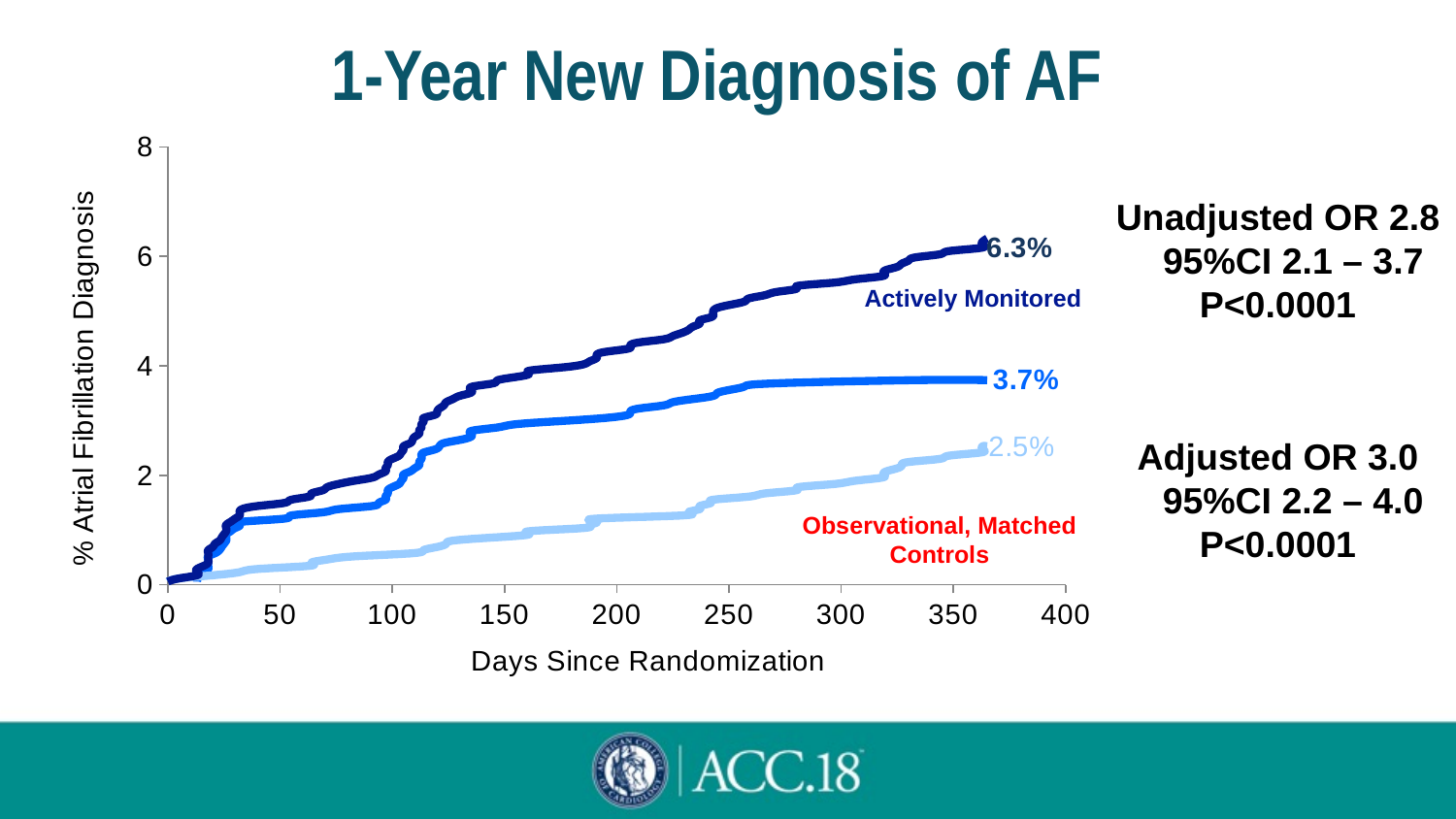
Do the plotted lines rise or fall as days since randomization increase? rise Is the value of the lowest (light blue) line at day 200 greater or less than 2? less Is the value of the Actively Monitored line at day 250 greater or less than 4? greater What value is labelled at the end of the lowest (light blue) line? 2.5% What is the title of the x axis? Days Since Randomization What is the difference between the end values labelled 6.3% and 2.5%? 3.8 percentage points What kind of chart is shown on the slide? line chart What is the difference between the end values labelled 6.3% and 3.7%? 2.6 percentage points What is the 1-year value labelled at the end of the Actively Monitored line? 6.3% How many lines are plotted on the chart? 3 Which line ends at the highest value at the end of the follow-up? Actively Monitored What value is labelled at the end of the middle (medium blue) line? 3.7%